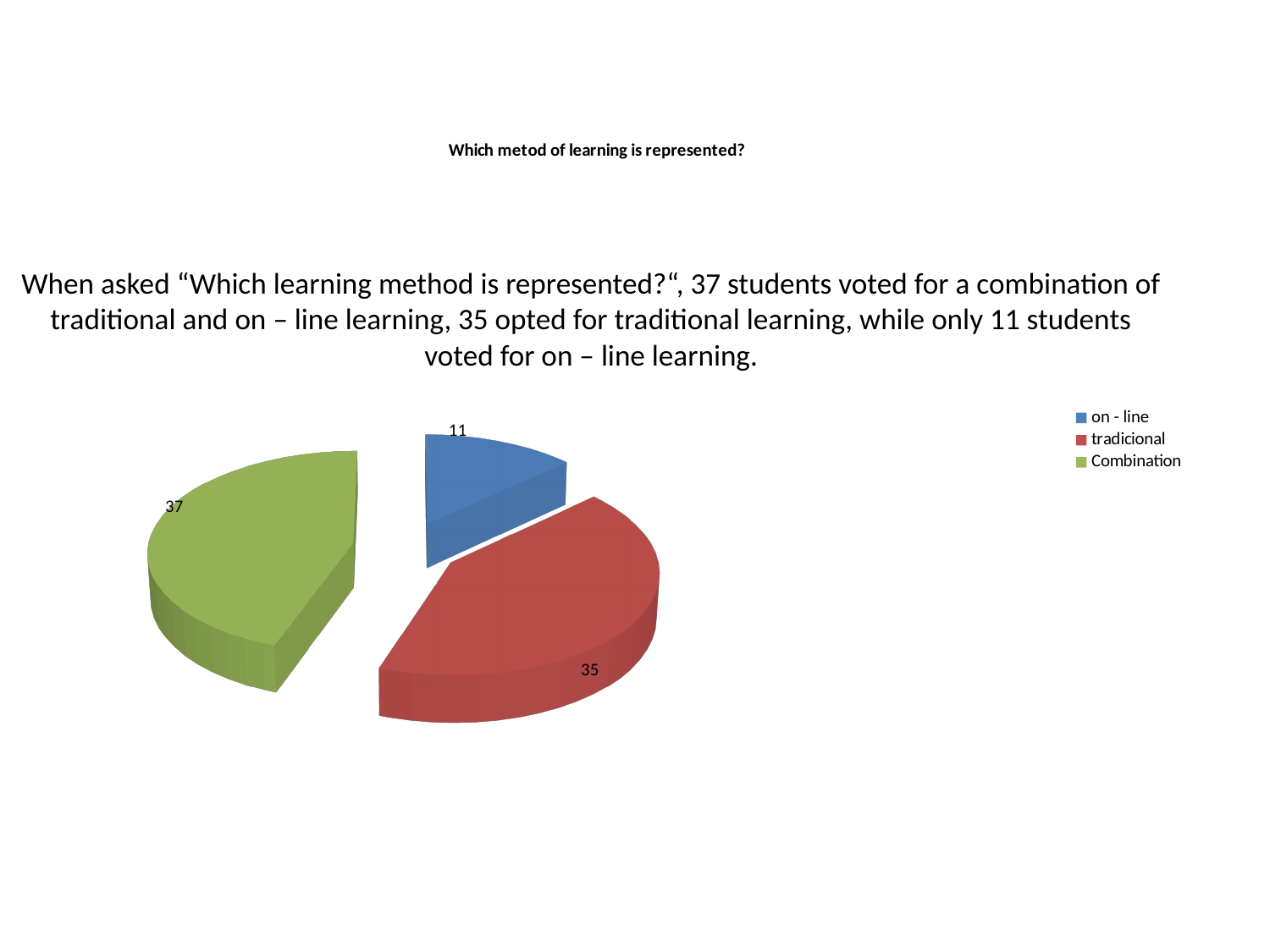
Which category has the smallest slice in the pie chart? on - line What colour is the Combination slice in the pie chart? green Which is larger in the pie chart, the on - line slice or the tradicional slice? tradicional What kind of chart is shown on the slide? pie chart What value is shown for the tradicional slice of the pie chart? 35 What is the total of all the values shown in the pie chart? 83 How many slices does the pie chart have? 3 How many students voted for on - line learning according to the pie chart? 11 What is the difference between the Combination value and the tradicional value in the pie chart? 2 What value is shown for the Combination slice of the pie chart? 37 What is the difference between the tradicional value and the on - line value in the pie chart? 24 Which category has the largest slice in the pie chart? Combination